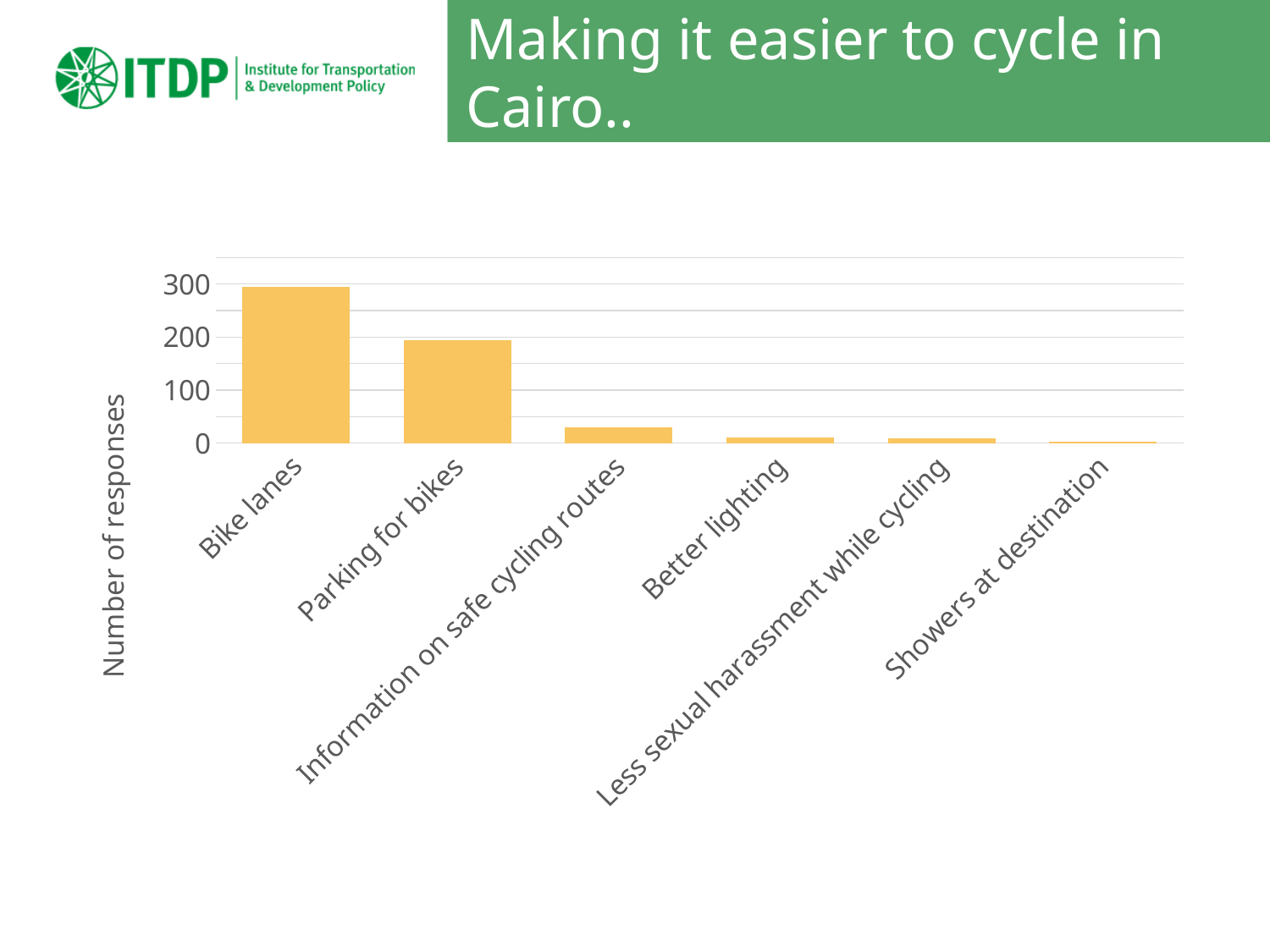
Do the values rise or fall moving from left to right along the x axis? fall Is the value for Bike lanes greater or less than 200? greater What kind of chart is shown on the slide? bar chart Which category has the lowest number of responses? Showers at destination Is the value for Parking for bikes greater or less than 100? greater Which category has the highest number of responses? Bike lanes How many categories are shown on the x axis of the chart? 6 Is the value for Information on safe cycling routes greater or less than 100? less Which has more responses, Bike lanes or Parking for bikes? Bike lanes Which has more responses, Parking for bikes or Information on safe cycling routes? Parking for bikes What colour are the bars in the chart? yellow What is the label on the y axis of the chart? Number of responses